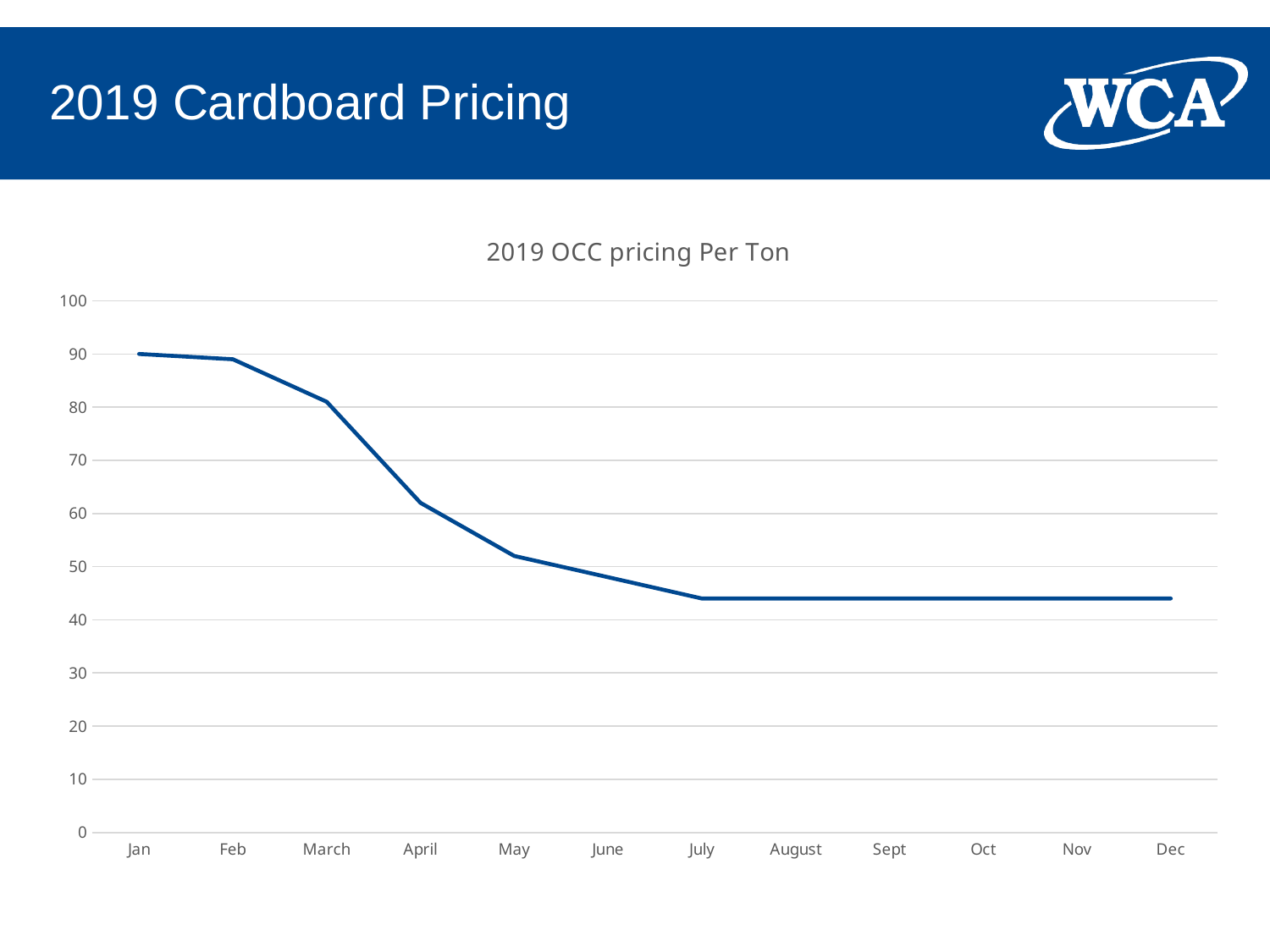
What is the title of the chart? 2019 OCC pricing Per Ton What kind of chart is shown on the slide? line chart Is the value for June greater or less than 50? less Is the value for Dec greater or less than 40? greater How many months are plotted along the x axis? 12 Is the value for April greater or less than 60? greater Do the values generally rise or fall from Jan to Dec? fall Which is larger, the value for Jan or the value for Dec? Jan Which is larger, the value for March or the value for May? March Which month has the highest value? Jan